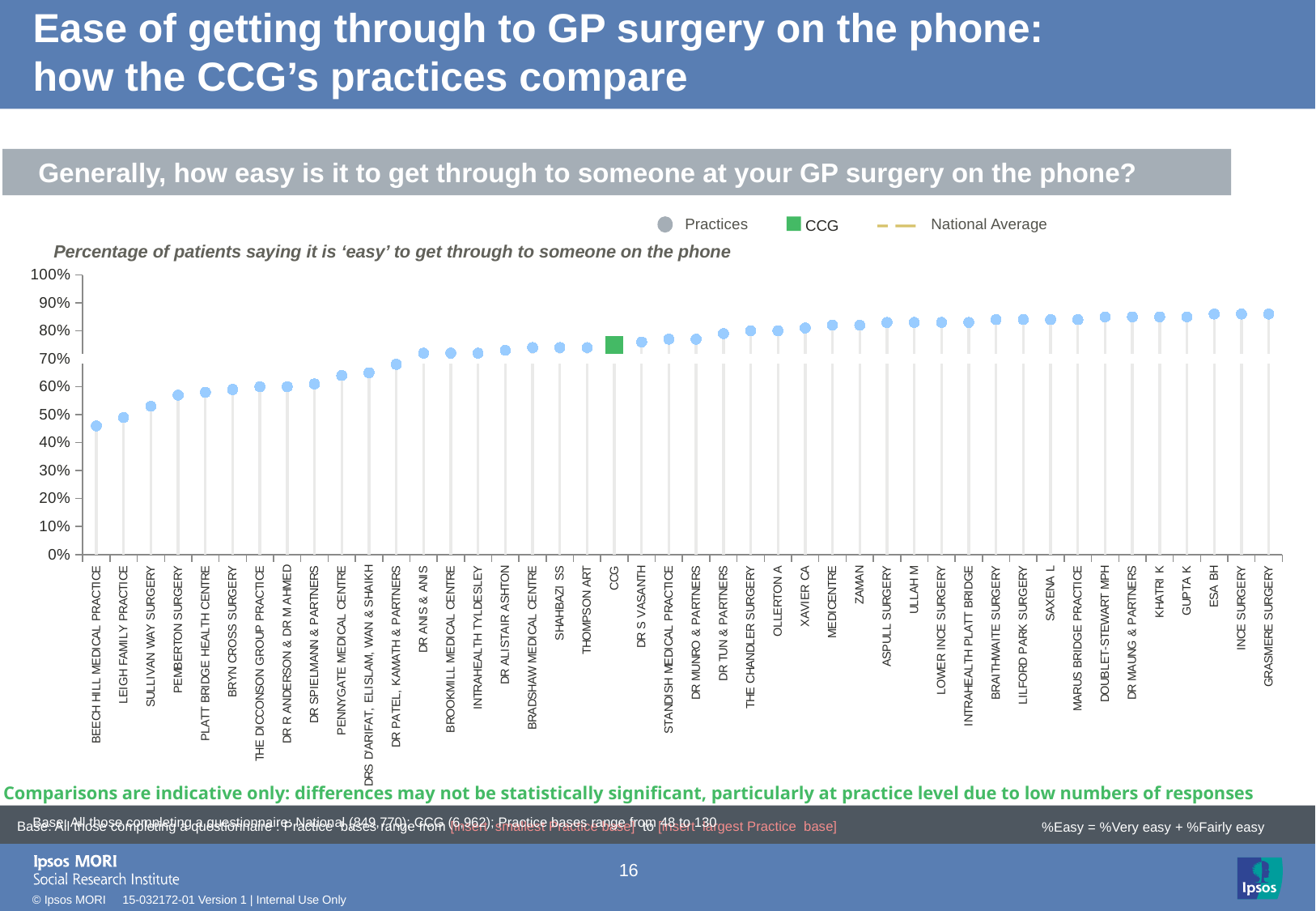
Do the values rise or fall moving from left to right along the x axis? rise What kind of chart is shown on the slide? Scatter/dot chart Is the value for GRASMERE SURGERY greater or less than 80%? greater Which has a higher value, PEMBERTON SURGERY or XAVIER CA? XAVIER CA Is the value for PENNYGATE MEDICAL CENTRE greater or less than 60%? greater Which practice has the lowest percentage of patients saying it is 'easy' to get through on the phone? BEECH HILL MEDICAL PRACTICE What colour is the CCG marker in the chart? Green Is the value for CCG greater or less than 70%? greater How many series does the legend list? 3 Which has a lower value, BEECH HILL MEDICAL PRACTICE or GRASMERE SURGERY? BEECH HILL MEDICAL PRACTICE